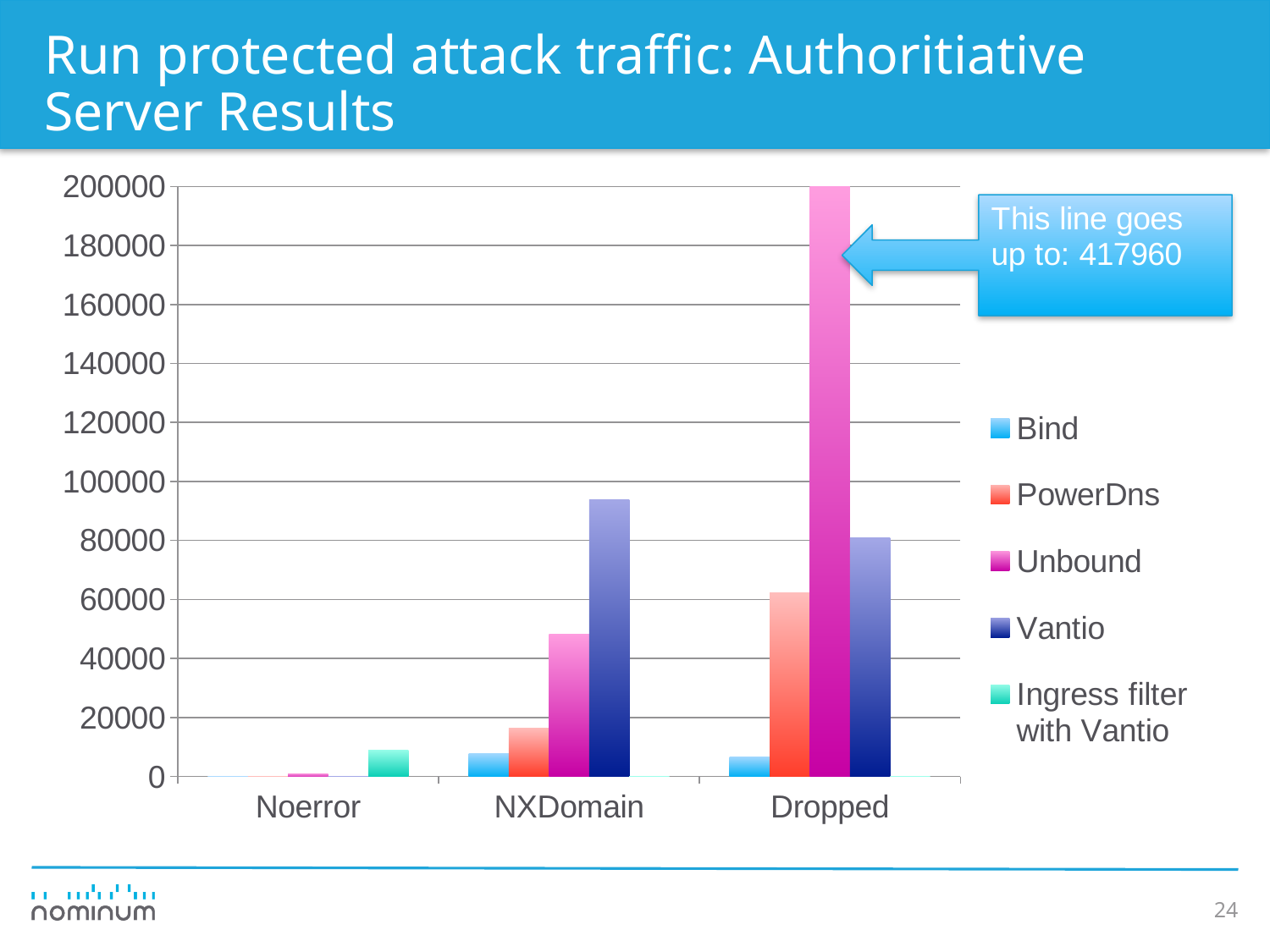
How many categories are shown on the x axis? 3 How many series does the legend list? 5 According to the callout, what value does the Unbound bar for Dropped reach? 417960 Which series has the highest value in the Dropped category? Unbound In the NXDomain category, which is larger: Vantio or Unbound? Vantio Is the value for Bind in the NXDomain category greater or less than 20000? less In the Dropped category, which is larger: PowerDns or Vantio? Vantio Which series has the highest value in the NXDomain category? Vantio Is the value for Vantio in the NXDomain category greater or less than 80000? greater What type of chart is shown on the slide? bar chart Is the value for Unbound in the NXDomain category greater or less than 60000? less What is the title of the slide containing the chart? Run protected attack traffic: Authoritiative Server Results